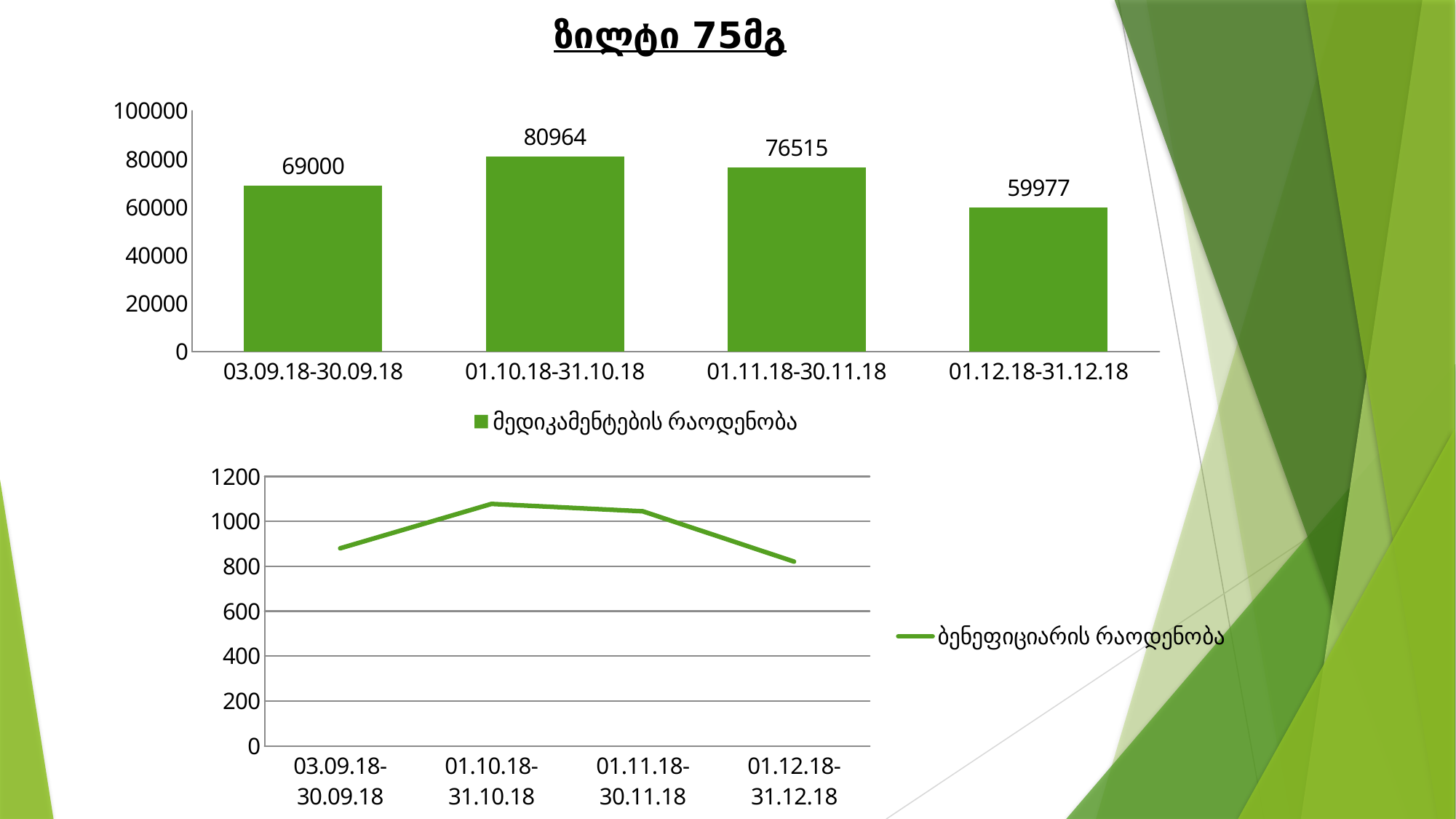
In the top bar chart, which period has the lowest value? 01.12.18-31.12.18 In the top bar chart, which period has the highest value? 01.10.18-31.10.18 How many bars are in the top bar chart? 4 In the top bar chart, what is the difference between the values for 01.10.18-31.10.18 and 01.11.18-30.11.18? 4449 In the bottom line chart, is the value for 01.10.18-31.10.18 greater or less than 1000? greater In the top bar chart, what is the value for 01.10.18-31.10.18? 80964 In the top bar chart, which is larger: the value for 03.09.18-30.09.18 or the value for 01.11.18-30.11.18? 01.11.18-30.11.18 In the top bar chart, what is the value for 01.12.18-31.12.18? 59977 What type of chart is the bottom chart on the slide? line chart What is the legend entry of the bottom line chart? ბენეფიციარის რაოდენობა What type of chart is the top chart on the slide? bar chart In the bottom line chart, is the value for 01.12.18-31.12.18 greater or less than 1000? less